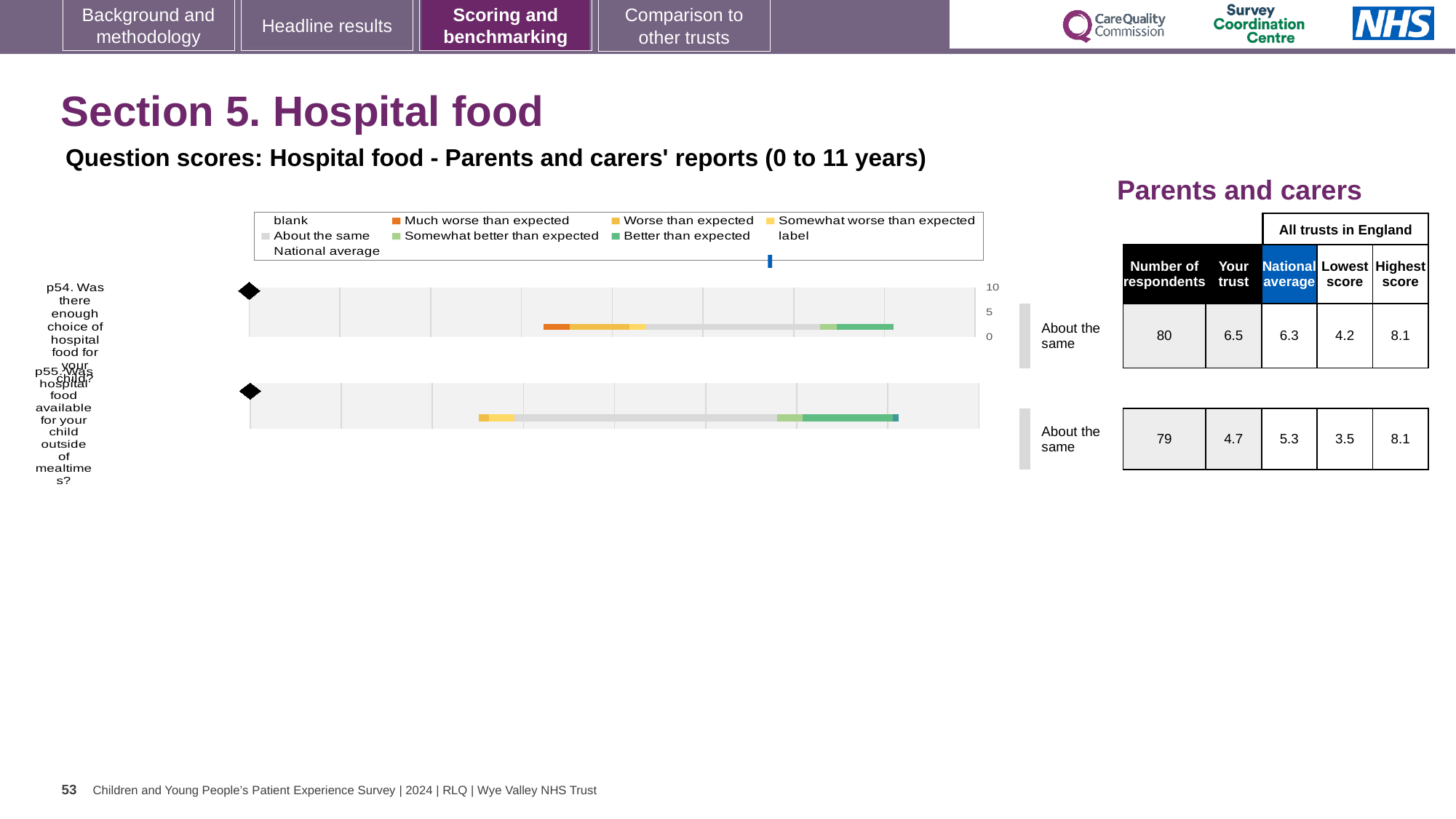
What is the national average score for p55? 5.3 What is the highest value shown on the chart's score axis? 10 What is the difference between the highest score and the lowest score for p54? 3.9 For p54, is the 'Your trust' score or the national average higher? Your trust How many respondents answered p54 (enough choice of hospital food)? 80 Which question has the higher 'Your trust' score, p54 or p55? p54 What is the 'Your trust' score for p55 (hospital food available outside of mealtimes)? 4.7 What benchmark category is shown for p55? About the same How many survey questions are plotted in the hospital food chart? 2 What is the highest score among all trusts in England for p55? 8.1 In the chart legend, which colour represents 'Much worse than expected'? orange What kind of chart is used to show the question scores for hospital food? bar chart